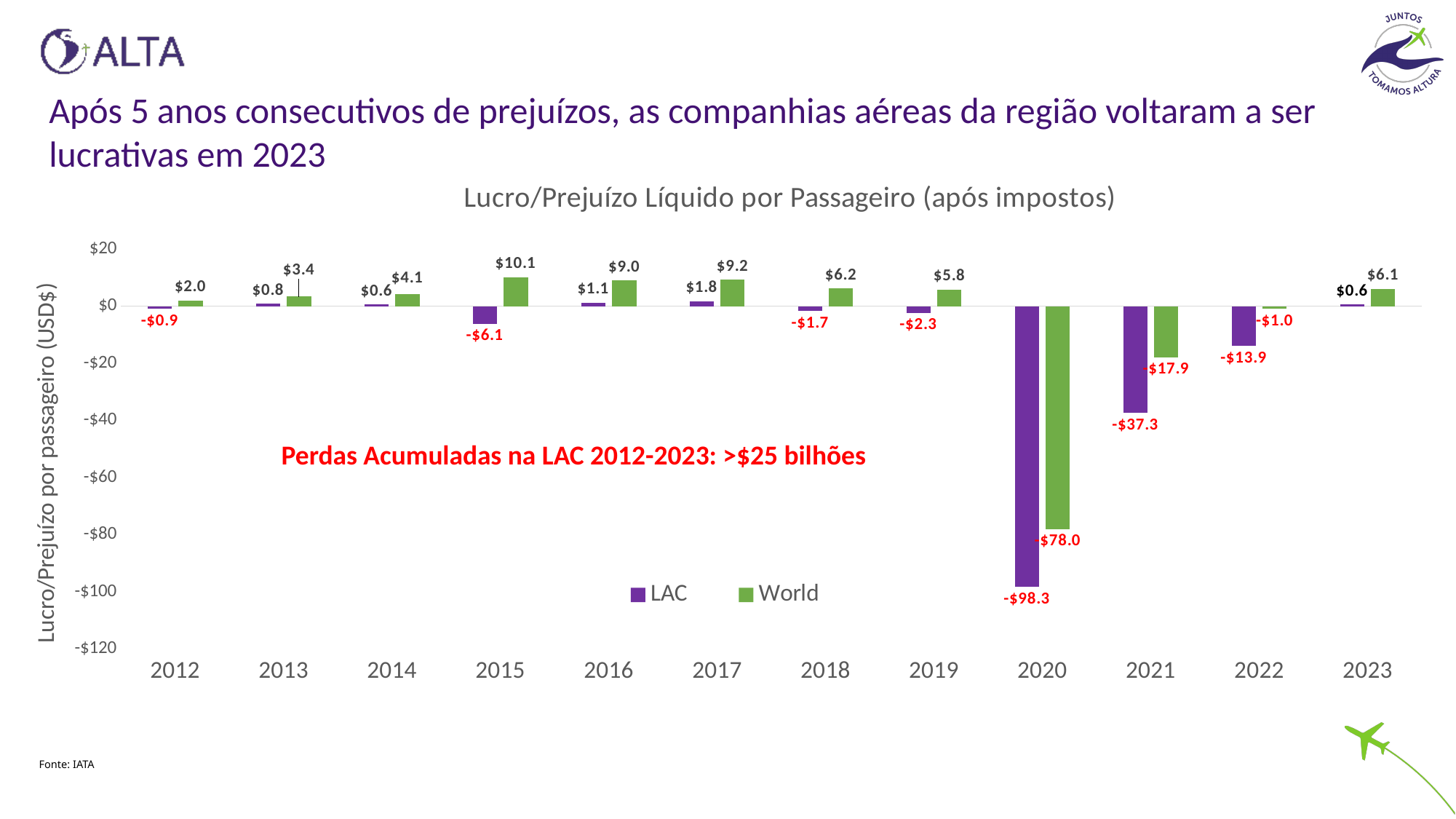
How many series does the legend list? 2 How many years are shown on the x axis? 12 Which is larger in 2017, the LAC value or the World value? World Which year has the lowest LAC value? 2020 What is the World value for 2015? $10.1 What type of chart is shown? Bar chart Is the LAC value for 2021 greater or less than -$20? less What is the LAC value for 2023? $0.6 What is the World value for 2022? -$1.0 What is the LAC value for 2020? -$98.3 What is the difference between the World and LAC values in 2021? $19.4 Which year has the highest World value? 2015